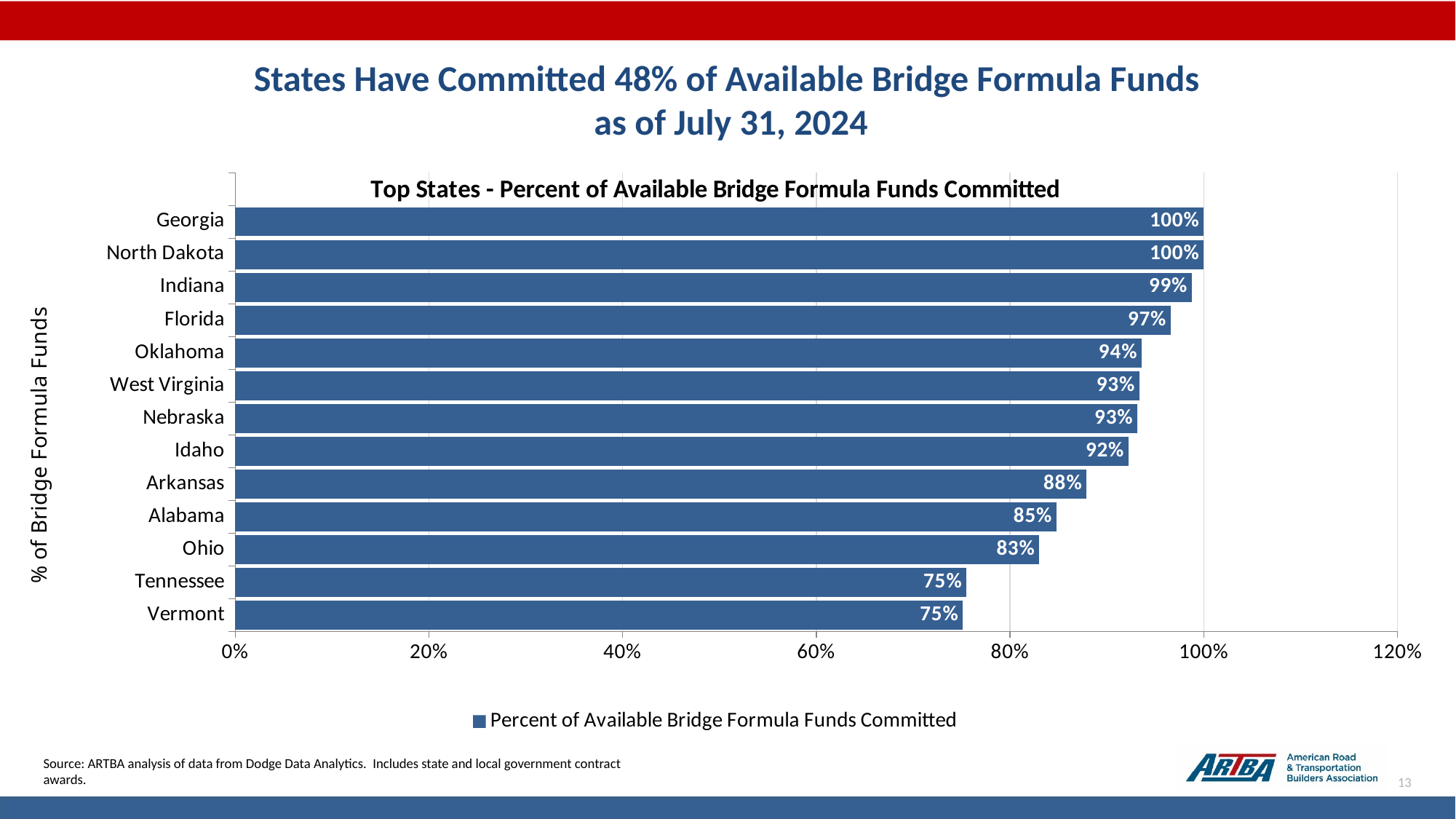
How many states are shown in the chart? 13 What is the value shown for Arkansas? 88% How many series does the legend list? 1 What percent of available Bridge Formula Funds has Ohio committed? 83% Which state has the lowest value among those shown, Tennessee or Vermont, or are they tied? Tied at 75% What percent of available Bridge Formula Funds has Florida committed? 97% What is the title of the chart? Top States - Percent of Available Bridge Formula Funds Committed Is the value for Alabama greater or less than 80%? greater What is the difference between Oklahoma's value and Idaho's value? 2% What is the difference between Indiana's value and Alabama's value? 14% Which has a higher value, Arkansas or Ohio? Arkansas What kind of chart is shown on the slide? Bar chart